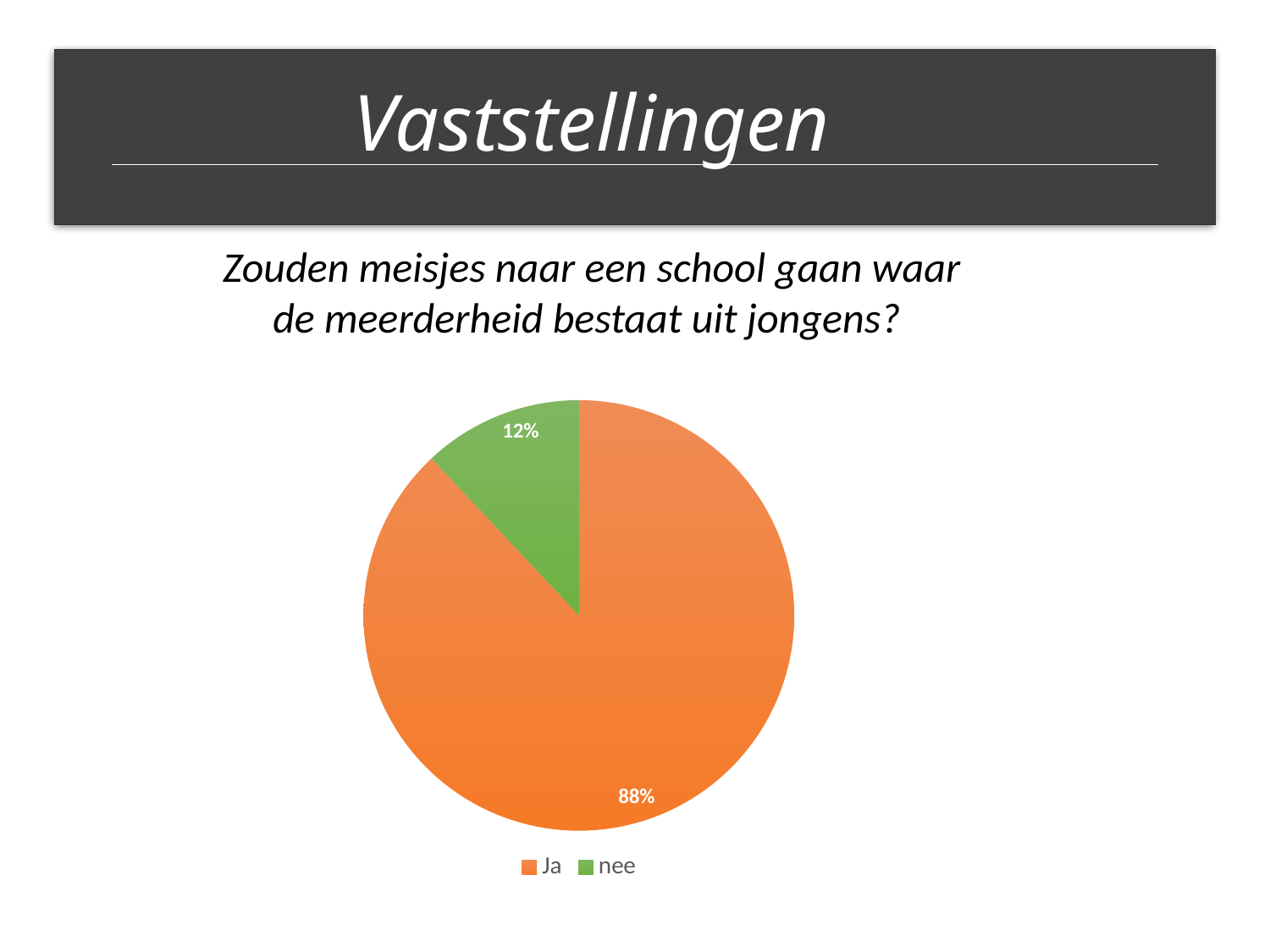
What colour is the "Ja" slice? orange Which slice is larger, "Ja" or "nee"? Ja How many categories does the pie chart show? 2 Which category has the largest slice of the pie? Ja How many entries does the legend list? 2 What kind of chart is shown on the slide? pie chart What share of the pie does "nee" represent? 12% What is the difference in percentage points between the "Ja" and "nee" slices? 76 What share of the pie does "Ja" represent? 88% What colour is the "nee" slice? green Which category has the smallest slice of the pie? nee